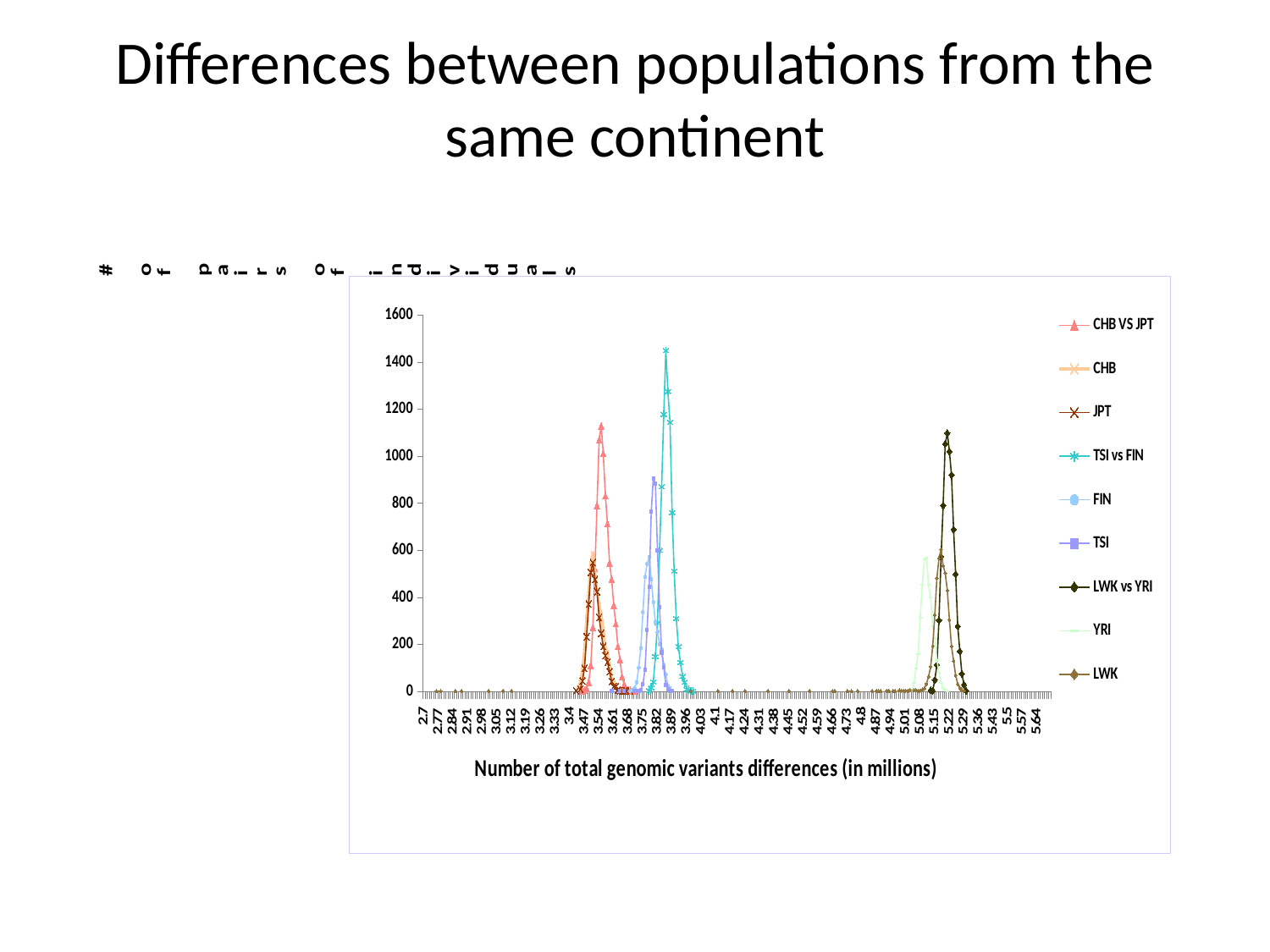
Is the peak value of the TSI series greater or less than 1000? less How many series does the legend list? 9 Which series reaches the highest peak value? TSI vs FIN What is the highest tick value shown on the y axis? 1600 Is the peak value of the LWK vs YRI series greater or less than 1000? greater Which series has a higher peak, LWK vs YRI or TSI? LWK vs YRI Is the peak value of the CHB VS JPT series greater or less than 1000? greater What is the title of the x axis? Number of total genomic variants differences (in millions) Which series has a higher peak, TSI vs FIN or CHB VS JPT? TSI vs FIN What kind of chart is shown on the slide? line chart